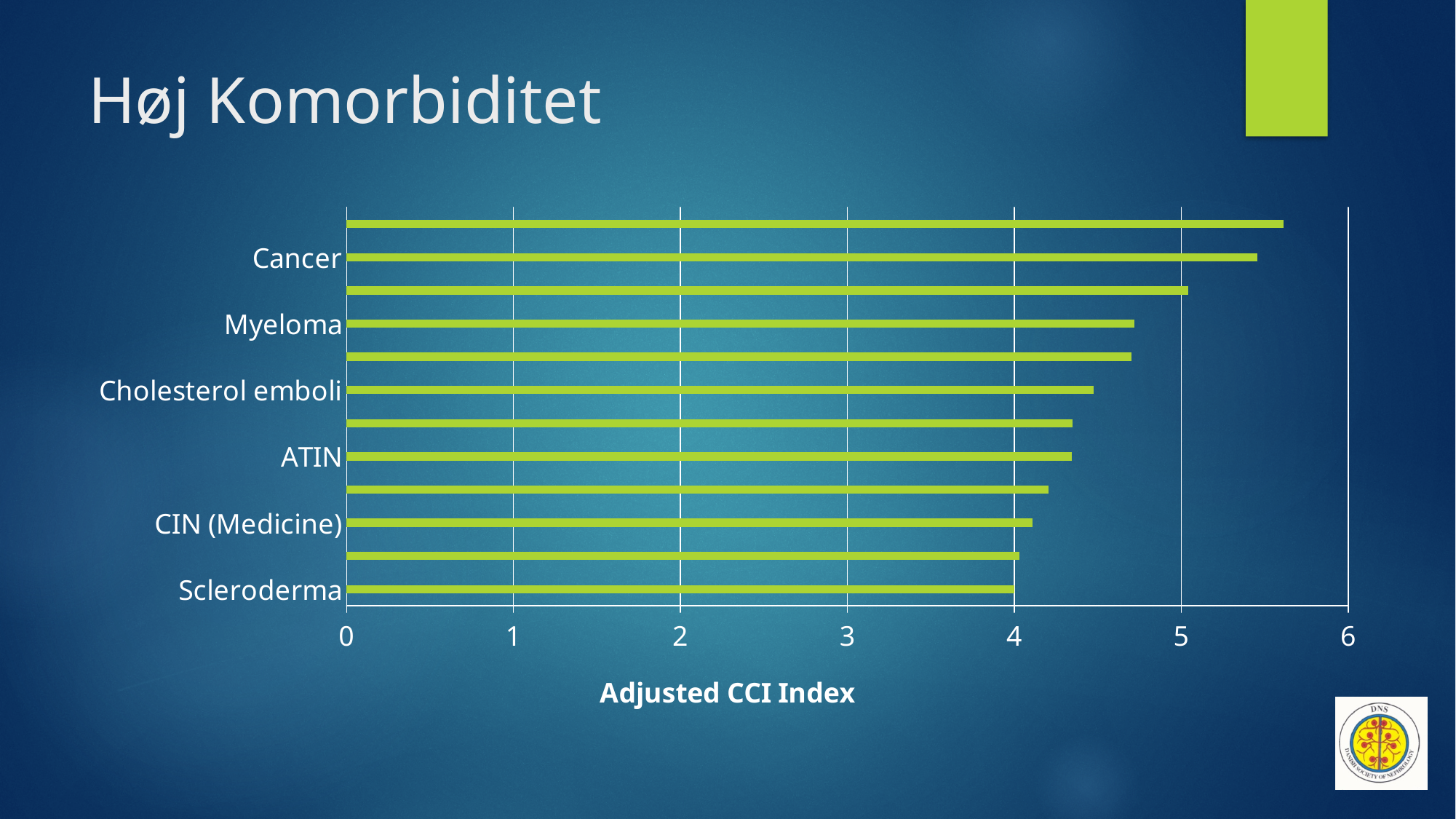
Is the value for Cholesterol emboli greater or less than 5? less Is the value for Cancer greater or less than 5? greater Among the labeled categories, which has the highest Adjusted CCI Index? Cancer Is the value for Myeloma greater or less than 5? less What is the title of the x axis of the chart? Adjusted CCI Index Which has the larger value, Cholesterol emboli or CIN (Medicine)? Cholesterol emboli Which has the larger value, Myeloma or ATIN? Myeloma Which has the larger value, Cancer or Scleroderma? Cancer How many bars are plotted in the chart? 12 What kind of chart is shown on the slide? bar chart